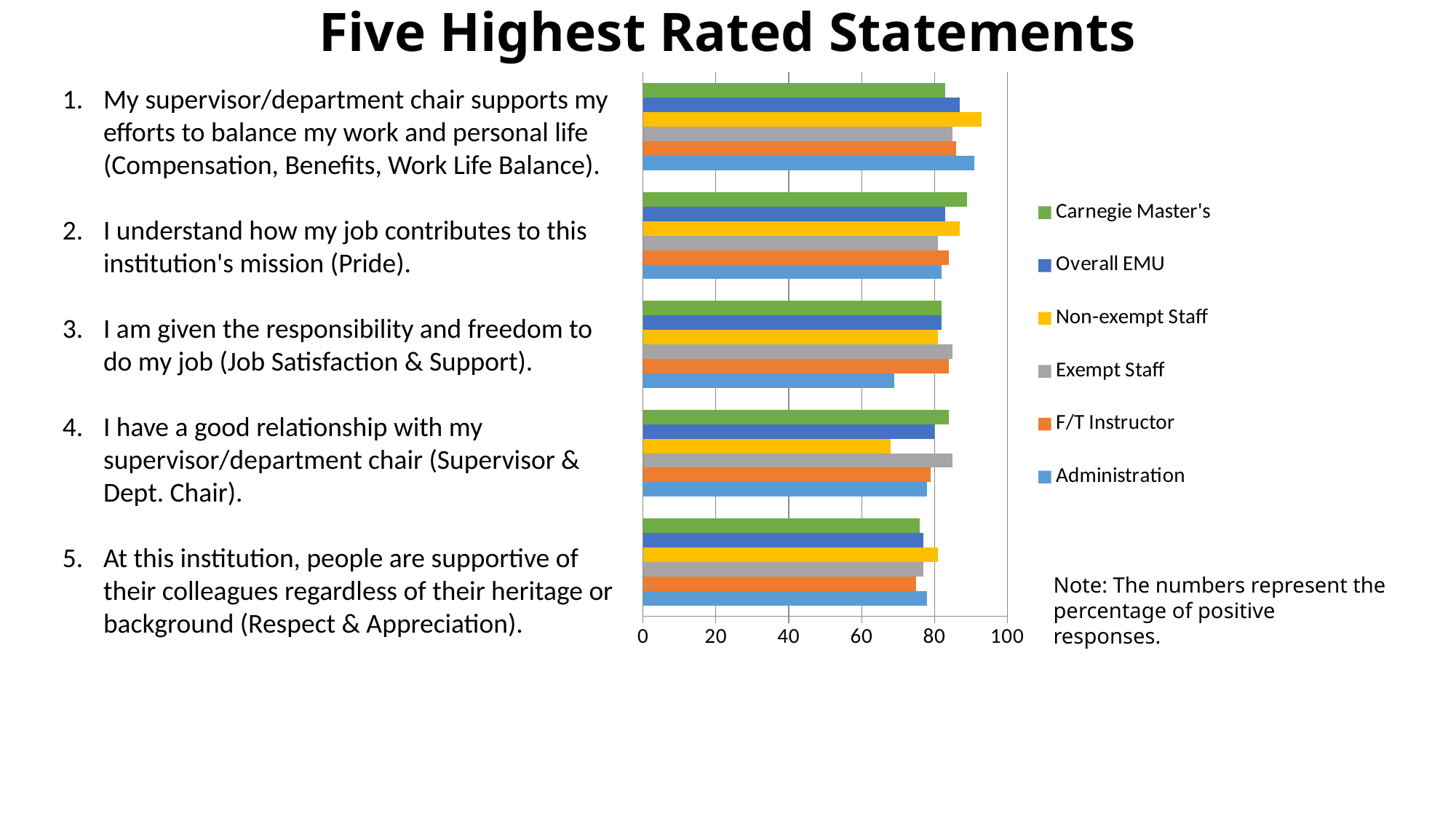
How many series does the chart's legend list? 6 How many groups of bars are plotted in the chart? 5 Which series is shown in yellow in the chart's legend? Non-exempt Staff In the fourth group of bars from the top, which series has the lowest value? Non-exempt Staff In the fourth group of bars from the top, is the value for Non-exempt Staff greater or less than 80? less In the third group of bars from the top, is the value for Administration greater or less than 80? less In the third group of bars from the top, which is larger: Exempt Staff or Administration? Exempt Staff What kind of chart is shown on the slide? bar chart In the third group of bars from the top, which series has the lowest value? Administration In the bottom group of bars, is the value for Carnegie Master's greater or less than 80? less Which series is listed first in the chart's legend? Carnegie Master's